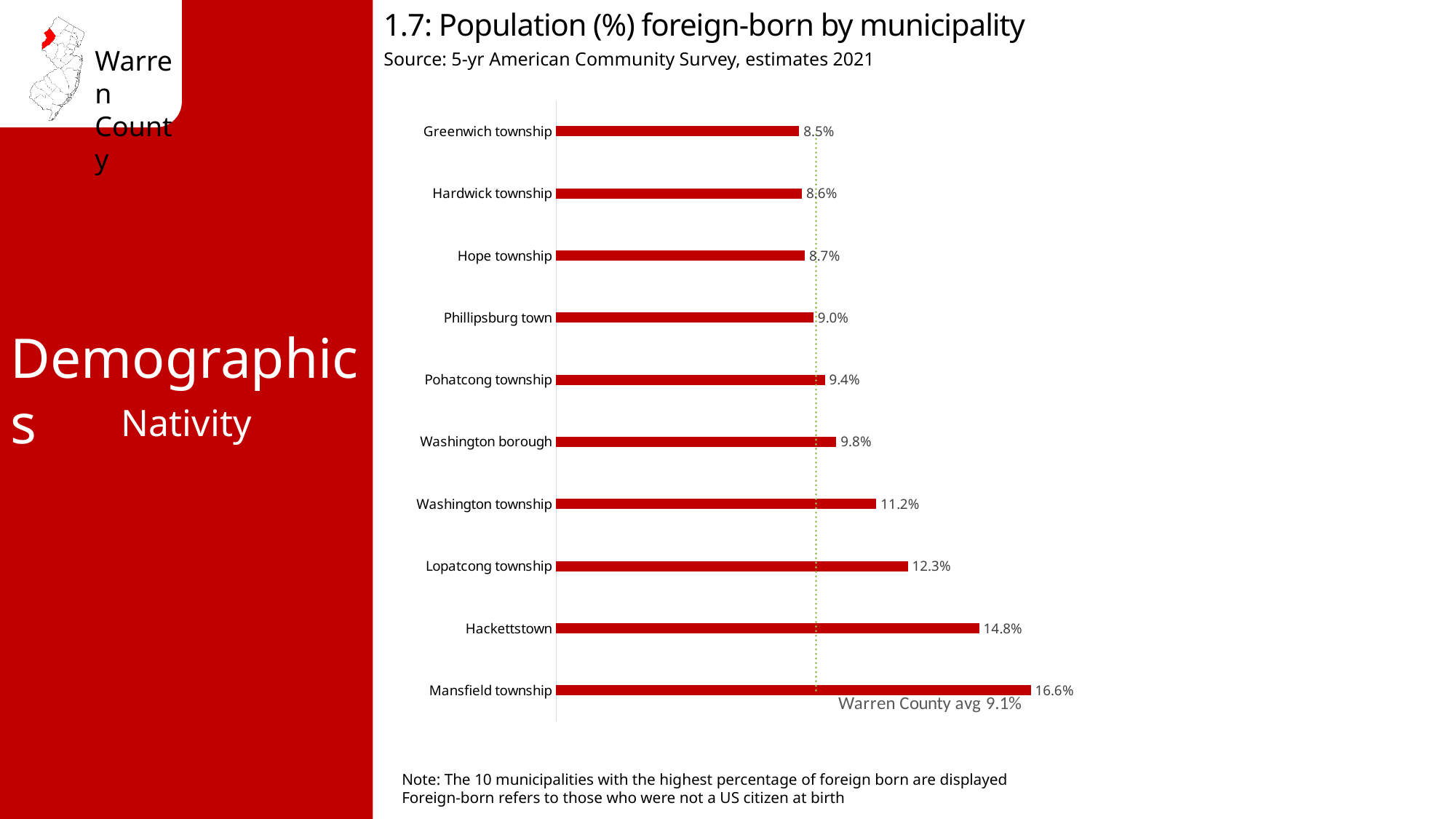
What is the difference in foreign-born percentage between Mansfield township and Hackettstown? 1.8% What is the title of the chart? 1.7: Population (%) foreign-born by municipality What type of chart is used on this slide? Bar chart What is the Warren County average foreign-born percentage shown by the dotted line? 9.1% What is the percentage of foreign-born population for Hackettstown? 14.8% Which has a higher foreign-born percentage, Pohatcong township or Hope township? Pohatcong township What is the percentage of foreign-born population for Phillipsburg town? 9.0% What is the difference in foreign-born percentage between Lopatcong township and Washington township? 1.1% How many municipalities are shown in the chart? 10 Which municipality has the highest percentage of foreign-born population? Mansfield township Which municipality has the lowest percentage of foreign-born population? Greenwich township What is the percentage of foreign-born population for Washington borough? 9.8%